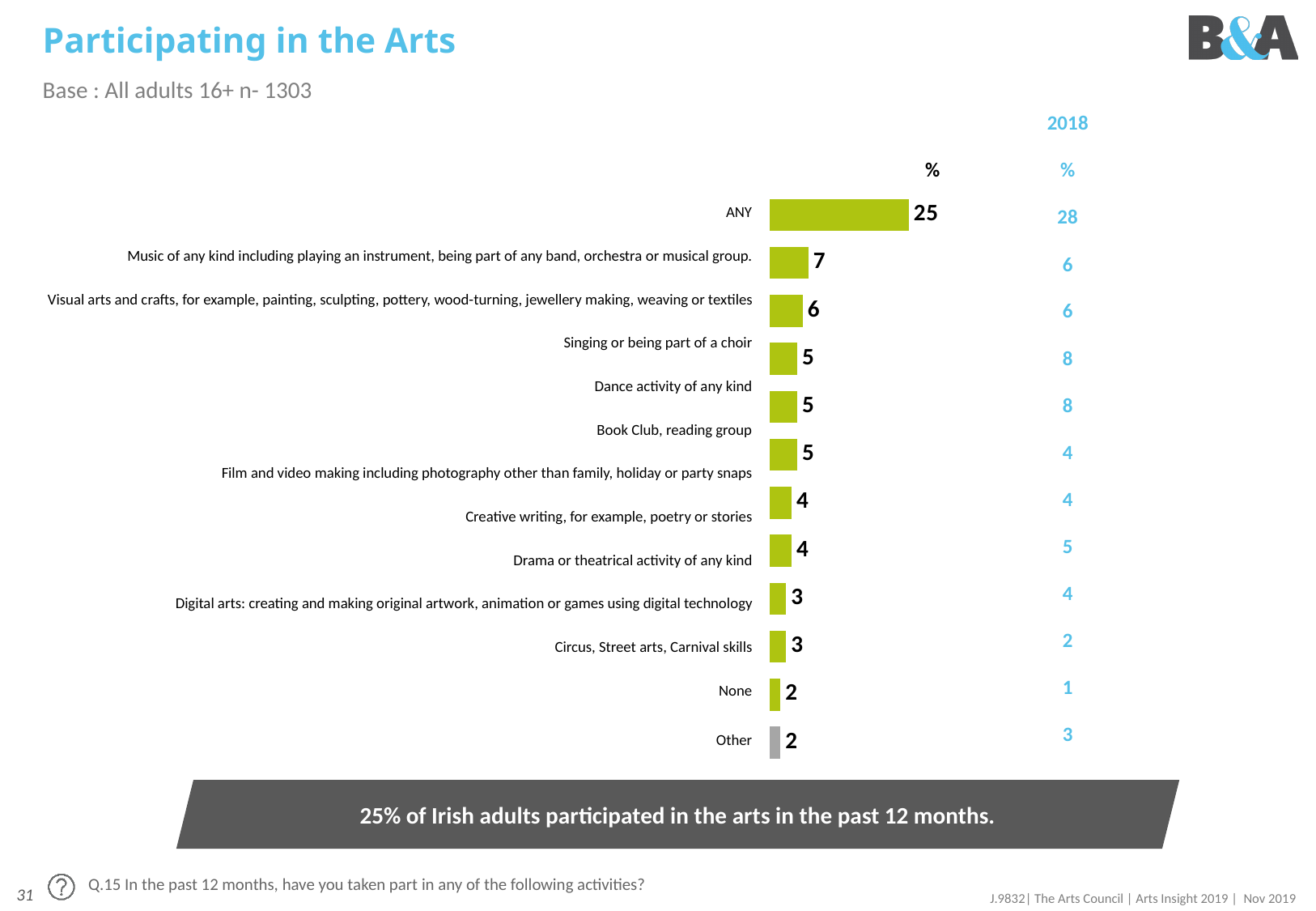
What is the title of the slide containing the chart? Participating in the Arts What kind of chart is shown on the slide? Bar chart Which category has the highest value in the bar chart? ANY What colour are most of the bars in the chart? Green What is the value for ANY in the bar chart? 25 How many bars are plotted in the chart? 12 What is the difference between the value for ANY and the value for Music of any kind? 18 What is the difference between the value for Music of any kind and the value for Visual arts and crafts? 1 What is the value for 'Music of any kind including playing an instrument, being part of any band, orchestra or musical group'? 7 What is the value for 'Visual arts and crafts, for example, painting, sculpting, pottery, wood-turning, jewellery making, weaving or textiles'? 6 Which is larger, the value for ANY or the value for Music of any kind? ANY Which is larger, the value for Music of any kind or the value for Visual arts and crafts? Music of any kind